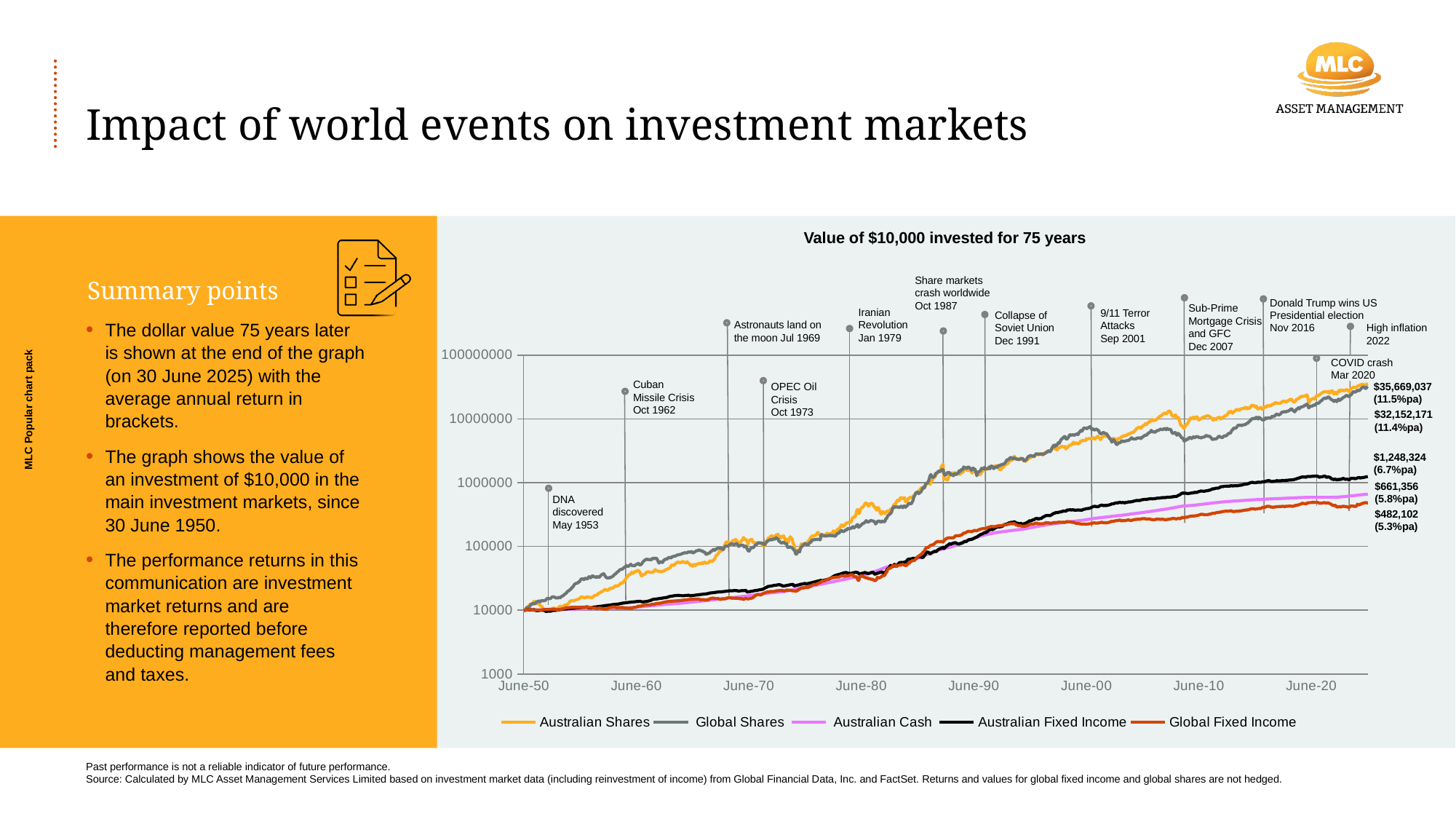
Do the values for Australian Shares generally rise or fall from June-50 to June-20? Rise What is the end value shown for Global Shares? $32,152,171 What is the title of the chart? Value of $10,000 invested for 75 years What kind of chart is shown on the slide? Line chart What is the end value shown for Global Fixed Income? $482,102 Which has a larger end value, Australian Cash or Global Fixed Income? Australian Cash What average annual return is shown in brackets for Australian Fixed Income? 6.7%pa How many series does the chart legend list? 5 What is the end value shown for Australian Shares? $35,669,037 Which series has the lowest end value? Global Fixed Income What is the difference between the end values of Australian Shares and Global Shares? $3,516,866 Which series has the highest end value? Australian Shares